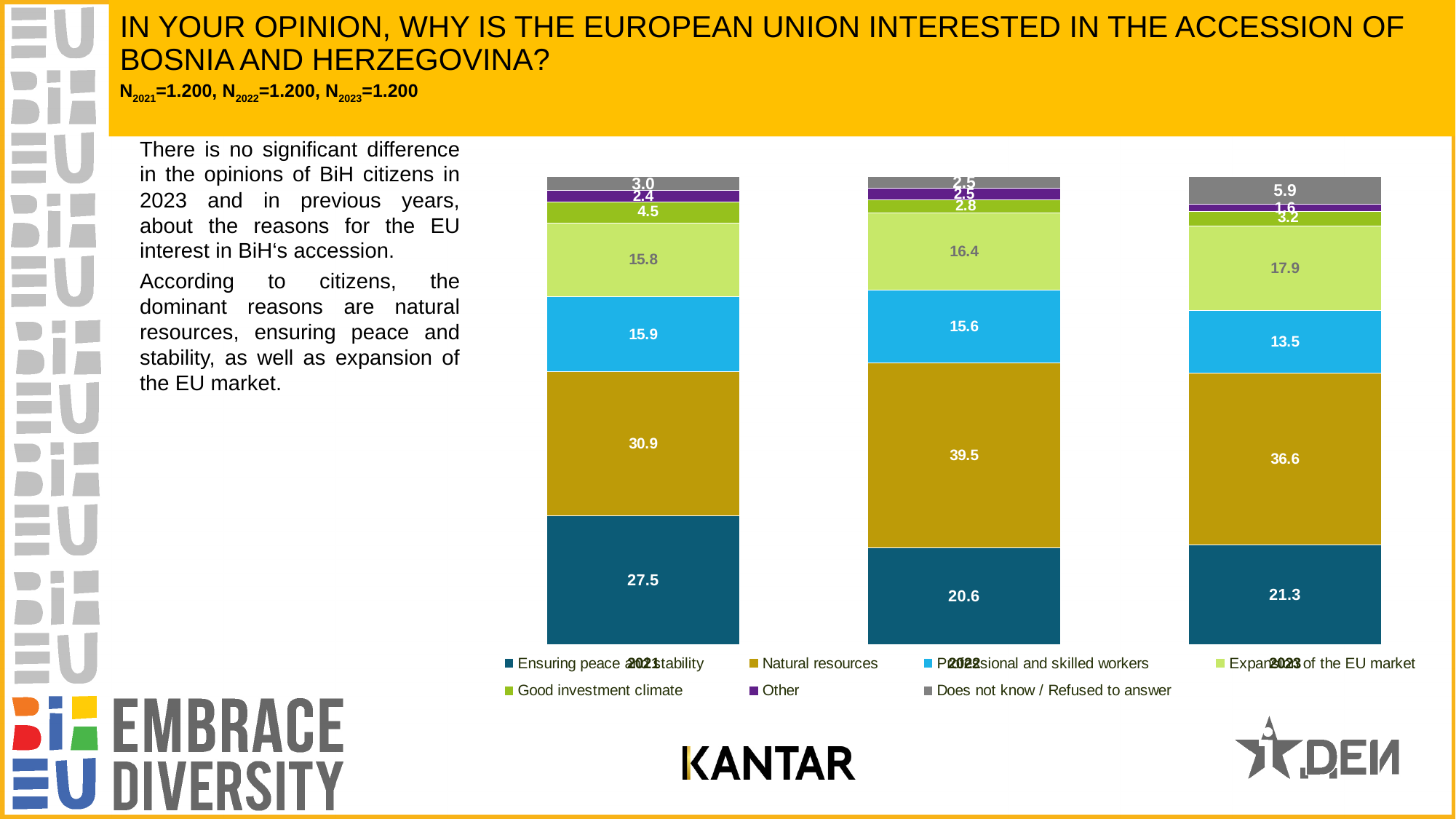
What is the value for Ensuring peace and stability in 2021? 27.5 How many bars (years) are shown in the chart? 3 What is the value for Expansion of the EU market in 2023? 17.9 Which is larger in 2023: Ensuring peace and stability or Expansion of the EU market? Ensuring peace and stability What is the value for Natural resources in 2022? 39.5 What is the difference between the Natural resources values in 2022 and 2021? 8.6 In which year is the value for Natural resources the highest? 2022 How many series does the legend list? 7 What is the value for Does not know / Refused to answer in 2023? 5.9 Does the value for Expansion of the EU market rise or fall from 2021 to 2023? Rise What kind of chart is shown on the slide? Stacked bar chart In which year is the value for Professional and skilled workers the lowest? 2023